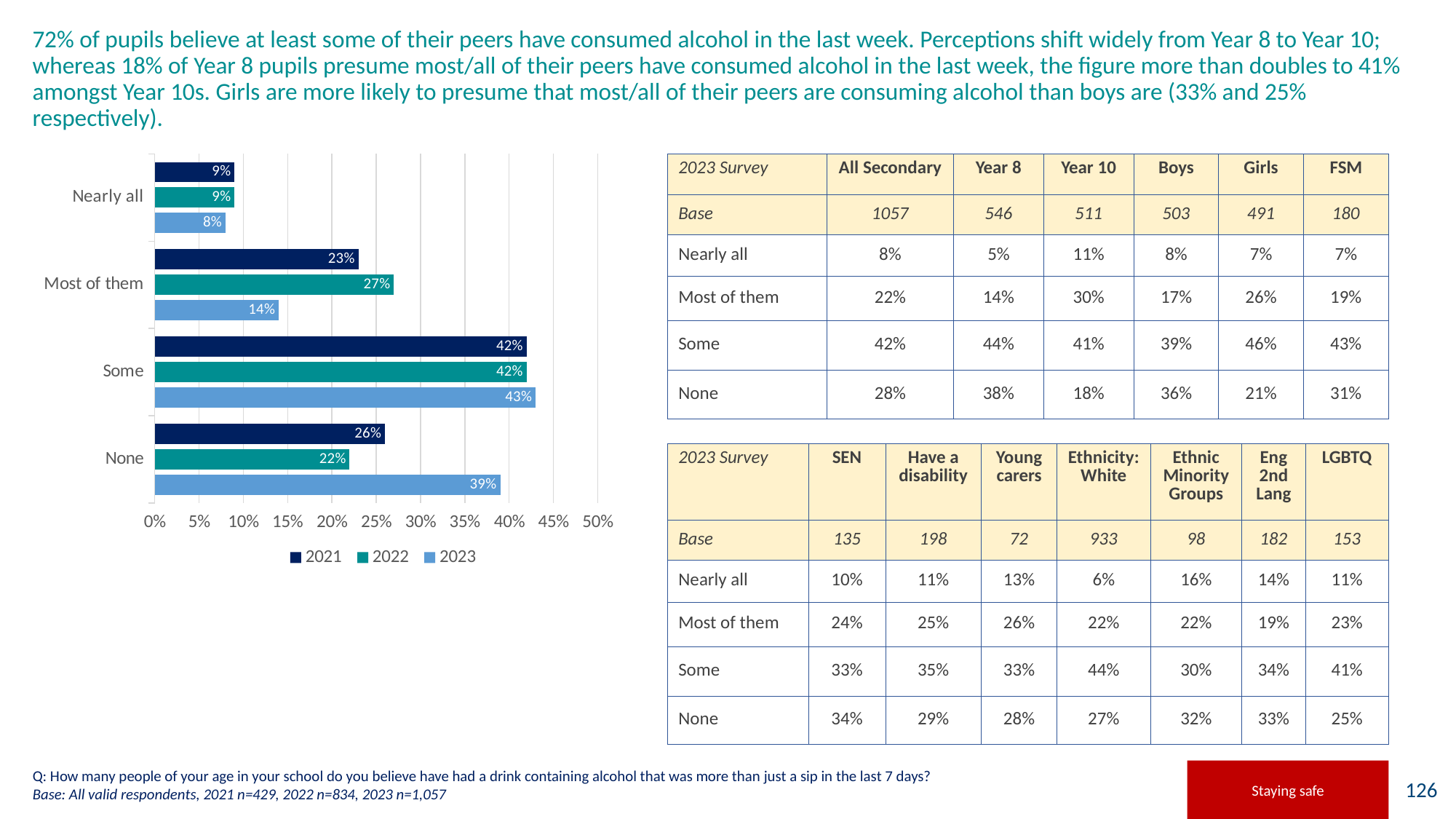
What is the 2022 value for 'Most of them' in the chart? 27% What is the 2021 value for 'Some' in the chart? 42% What is the difference between the 2023 and 2022 values for 'None' in the chart? 17% What is the difference between the 2022 and 2023 values for 'Most of them' in the chart? 13% How many categories are shown on the chart's vertical axis? 4 What is the 2023 value for 'None' in the chart? 39% Which is larger for 'Most of them': the 2021 value or the 2023 value? 2021 How many series does the chart legend list? 3 What kind of chart is shown on the slide? bar chart Which series in the chart legend is shown in the darkest blue colour? 2021 Which category has the highest 2023 value in the chart? Some Which category has the lowest 2021 value in the chart? Nearly all